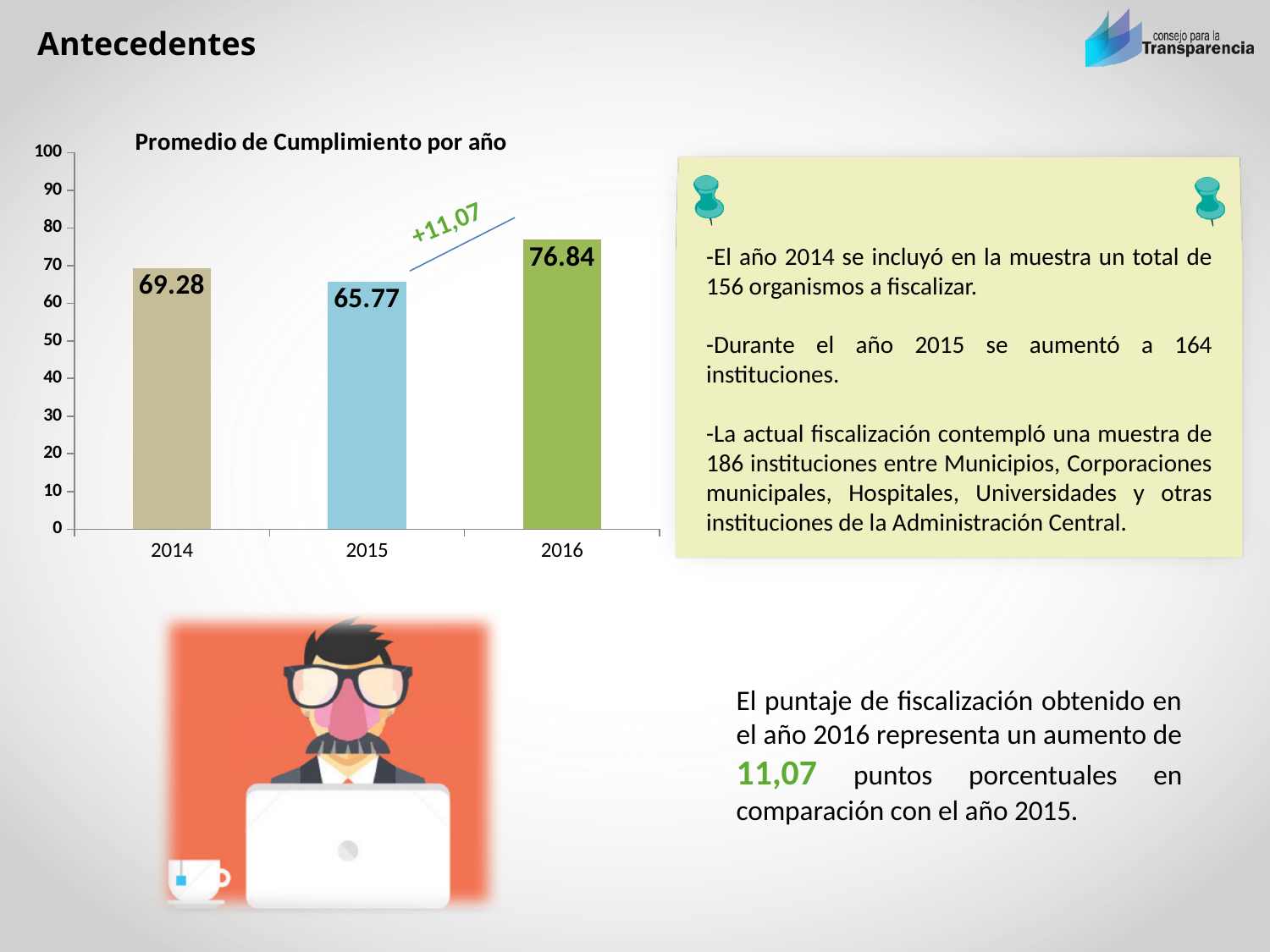
How many years are shown in the chart? 3 What is the value for 2014 in the chart? 69.28 What is the value for 2016 in the chart? 76.84 What is the value for 2015 in the chart? 65.77 What is the difference between the values for 2014 and 2015? 3.51 What kind of chart is shown on the slide? bar chart Which year has the lowest value in the chart? 2015 Which is larger, the value for 2014 or the value for 2016? 2016 Which year has the highest value in the chart? 2016 What is the difference between the values for 2016 and 2015? 11.07 Is the value for 2016 greater or less than 70? greater What is the title of the chart? Promedio de Cumplimiento por año